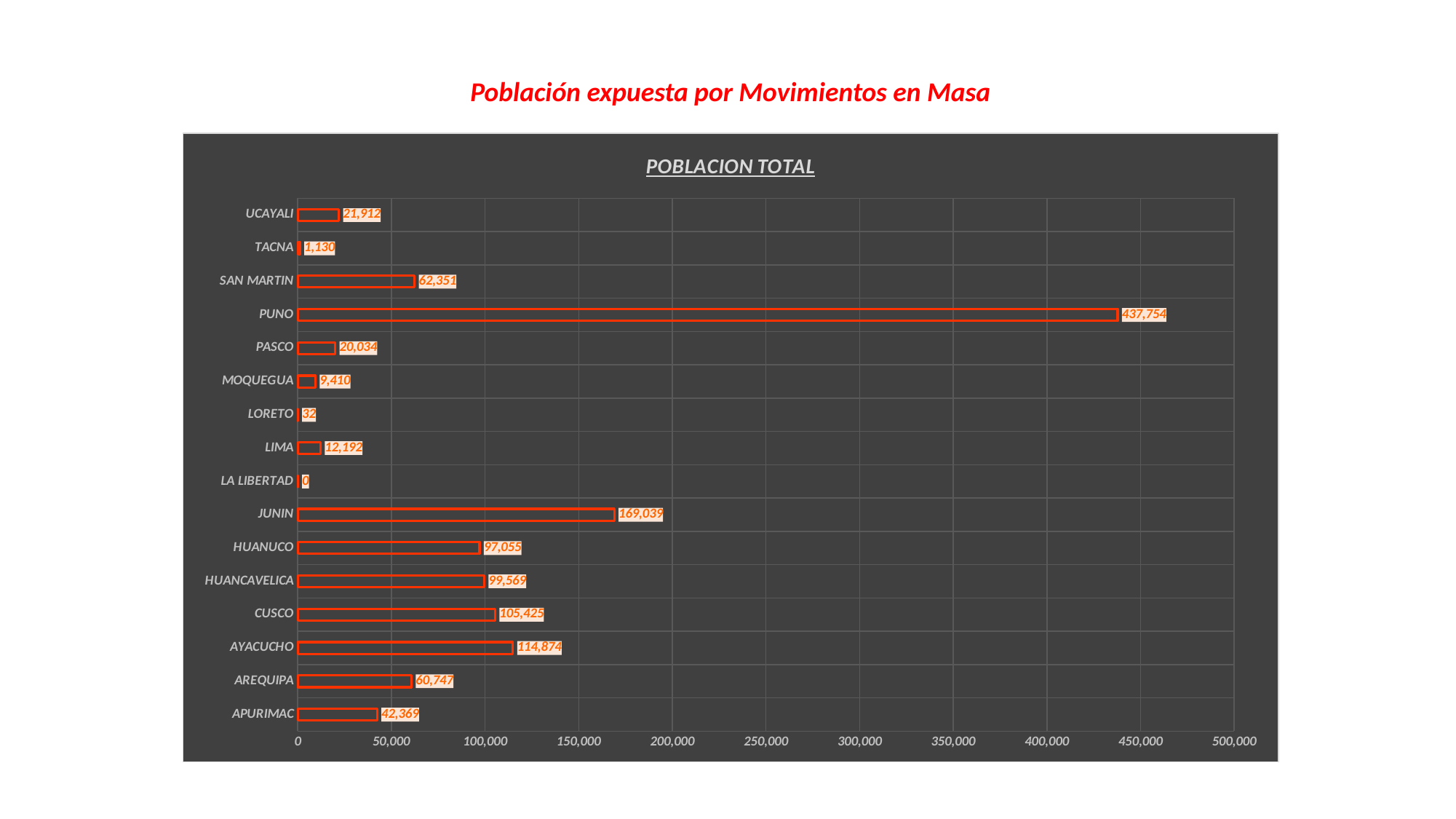
How many regions are shown in the chart? 16 What is the difference between the values for CUSCO and HUANCAVELICA? 5,856 Which region has the highest value? PUNO What kind of chart is shown on the slide? bar chart Is the value for PUNO greater or less than 400,000? greater Which region has the lowest value? LA LIBERTAD What is the value for PUNO? 437,754 What is the difference between the values for PUNO and JUNIN? 268,715 What is the value for LORETO? 32 What is the value for AREQUIPA? 60,747 Which is larger, the value for AYACUCHO or the value for CUSCO? AYACUCHO What is the value for JUNIN? 169,039